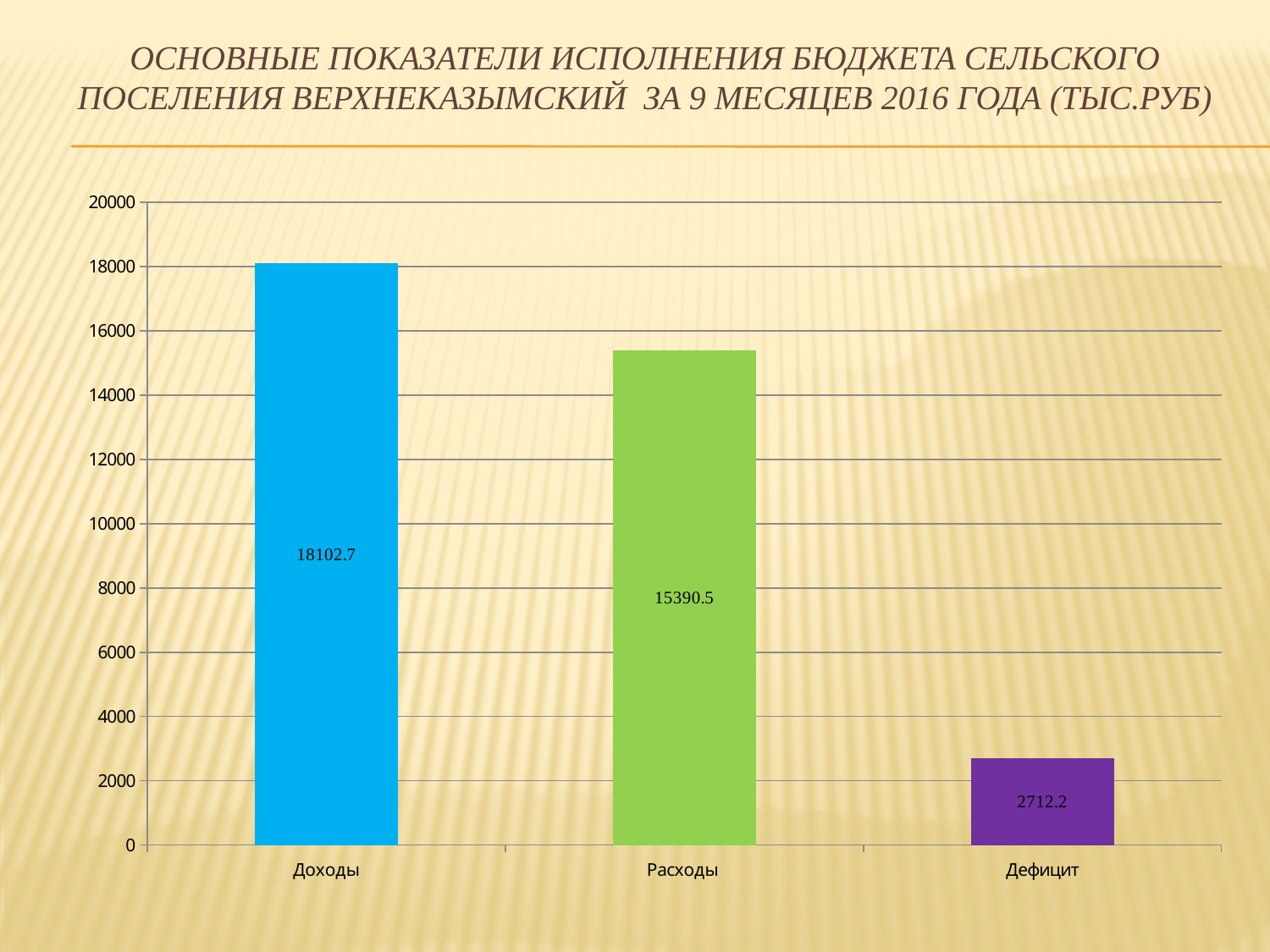
How many categories are shown on the x axis? 3 What is the difference between the values for Доходы and Расходы? 2712.2 What kind of chart is shown on the slide? bar chart What is the value for Расходы? 15390.5 Which category has the highest value? Доходы What is the value for Доходы? 18102.7 What is the difference between the values for Расходы and Дефицит? 12678.3 What colour is the bar for Дефицит? purple Which category has the lowest value? Дефицит Is the value for Расходы greater or less than 16000? less What is the value for Дефицит? 2712.2 Which is larger, the value for Расходы or the value for Дефицит? Расходы